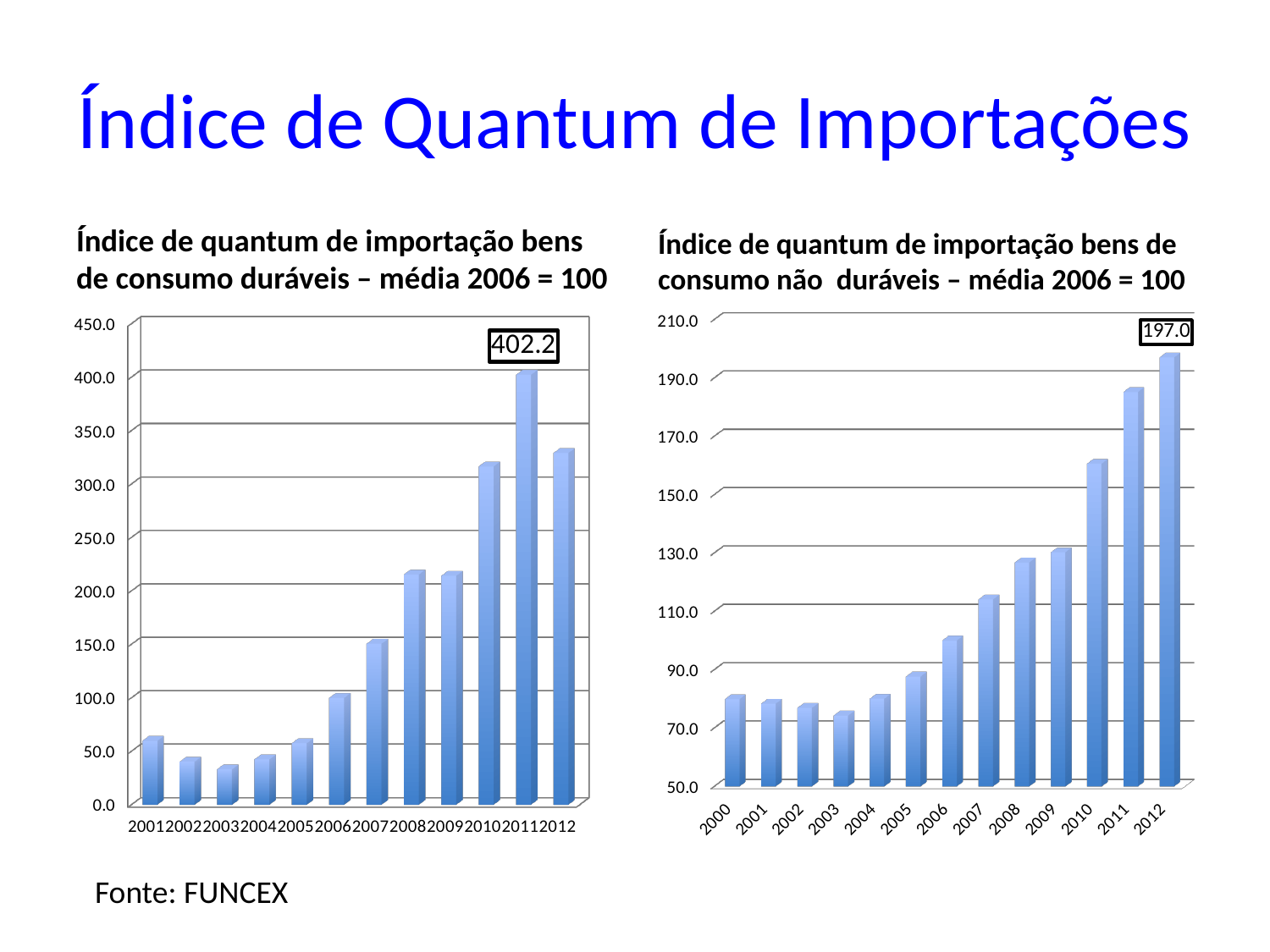
On the chart for bens de consumo não duráveis, which year has the highest value? 2012 On the chart for bens de consumo não duráveis, what value is labelled on the 2012 bar? 197.0 What kind of chart is the left chart (bens de consumo duráveis)? Bar chart On the chart for bens de consumo duráveis, what value is labelled on the 2011 bar? 402.2 On the chart for bens de consumo não duráveis, do the values generally rise or fall from 2003 to 2012? Rise On the chart for bens de consumo duráveis, which year has the lowest value? 2003 On the chart for bens de consumo não duráveis, how many years are shown on the x axis? 13 On the chart for bens de consumo duráveis, which year has the highest value? 2011 On the chart for bens de consumo duráveis, how many years are shown on the x axis? 12 On the chart for bens de consumo duráveis, is the value for 2010 greater or less than 300? greater On the chart for bens de consumo duráveis, which is larger, the value for 2011 or the value for 2012? 2011 On the chart for bens de consumo não duráveis, is the value for 2011 greater or less than 170? greater